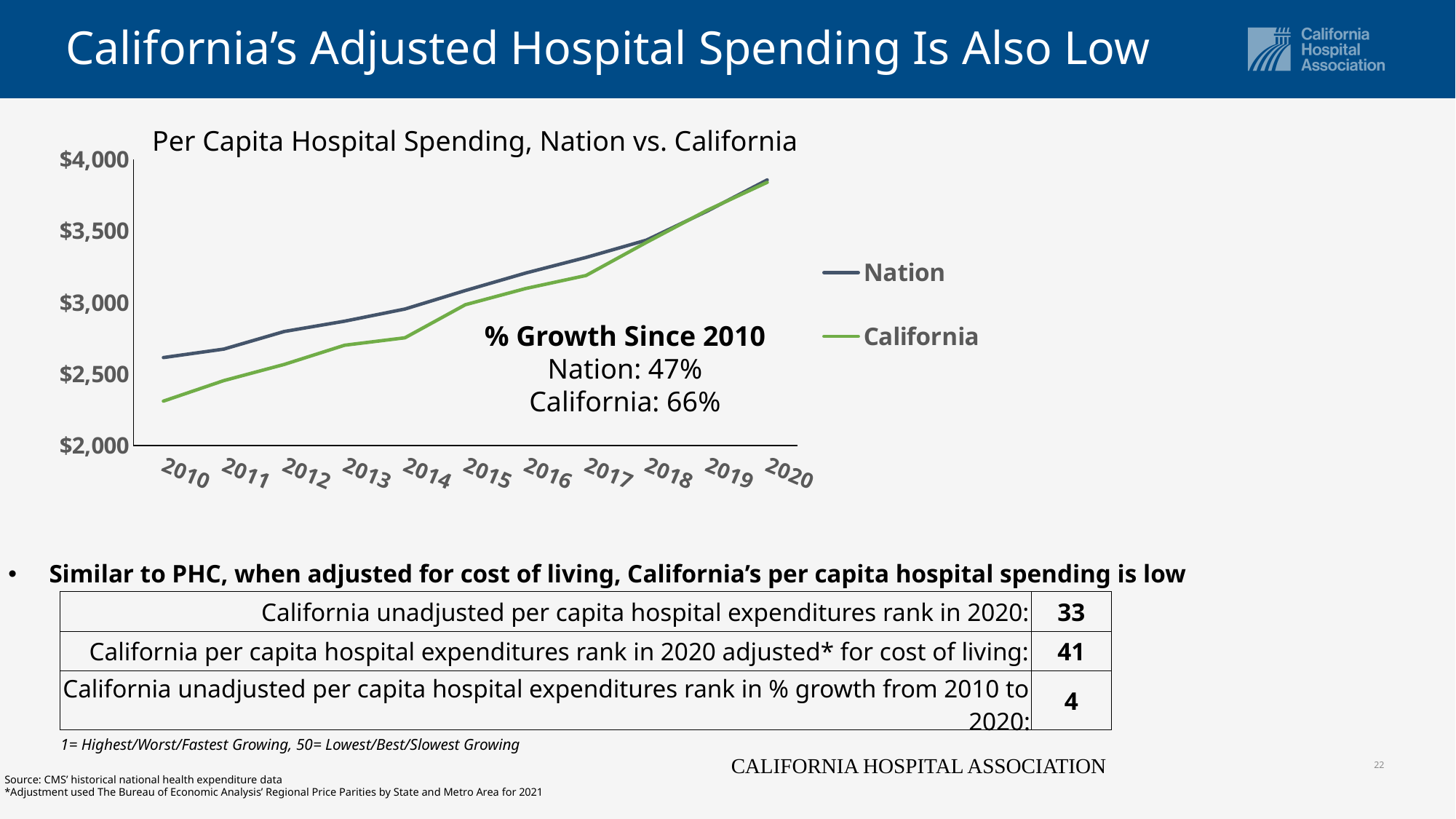
In 2010, which series has the larger value, Nation or California? Nation Is the value for California in 2020 greater or less than $3,500? greater How many series does the chart legend list? 2 How many years are plotted along the x axis of the chart? 11 Is the value for California in 2014 greater or less than $3,000? less What kind of chart is shown on the slide? line chart What is the title of the chart? Per Capita Hospital Spending, Nation vs. California In which year is the California series at its lowest value? 2010 Is the value for California in 2010 greater or less than $2,500? less According to the annotation on the chart, what is the % growth since 2010 for California? 66% Do the values for California rise or fall from 2010 to 2020? rise